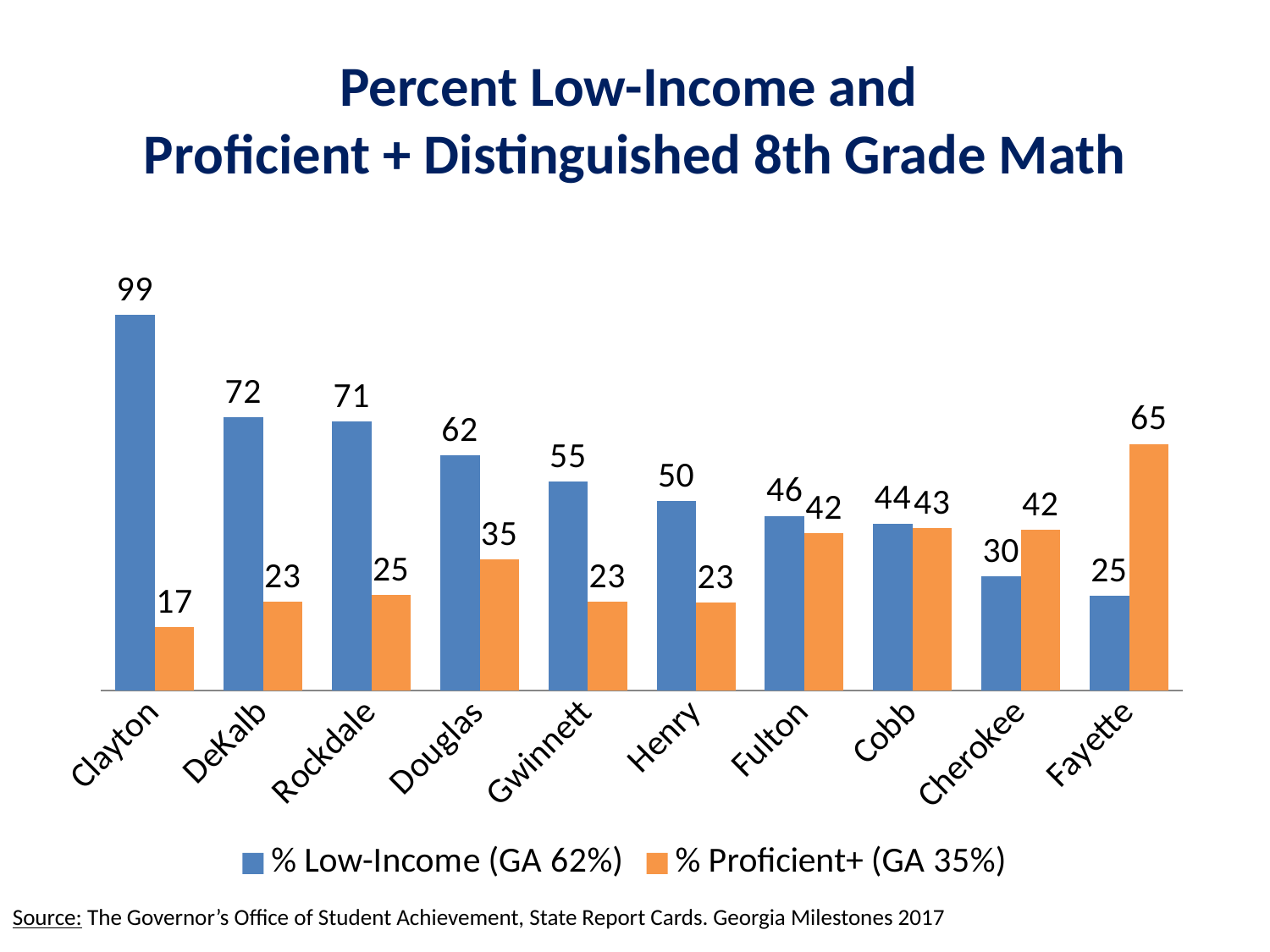
What is the % Proficient+ value for Fayette? 65 What is the difference between the % Low-Income and % Proficient+ values for DeKalb? 49 What kind of chart is shown on the slide? Bar chart Which county has the highest % Low-Income value? Clayton What colour are the % Proficient+ bars? Orange What is the % Low-Income value for Clayton? 99 Which is larger for Fayette: % Low-Income or % Proficient+? % Proficient+ How many counties are shown on the x axis? 10 What is the % Proficient+ value for Douglas? 35 How many series does the legend list? 2 Do the % Low-Income values generally rise or fall from Clayton to Fayette? Fall Which county has the lowest % Proficient+ value? Clayton